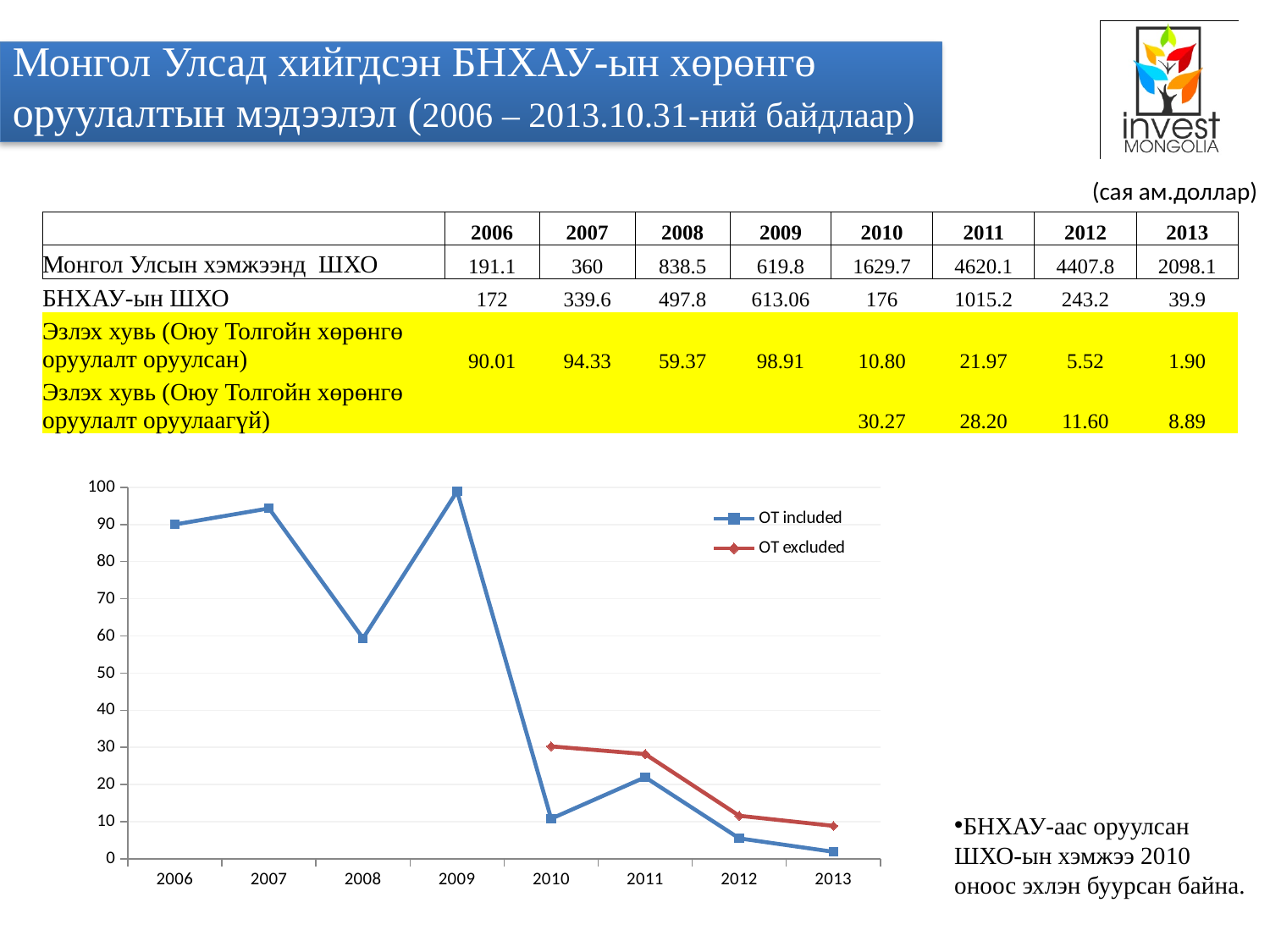
How many series does the chart legend list? 2 What are the two series named in the chart legend? OT included, OT excluded In which year does the OT included series reach its lowest value? 2013 In which year does the OT excluded series first appear on the chart? 2010 Does the OT excluded series rise or fall from 2010 to 2013? fall Is the OT included value for 2010 greater or less than 20? less Is the OT included value for 2008 greater or less than 50? greater What kind of chart is shown on the slide? line chart In 2011, which series has the larger value, OT included or OT excluded? OT excluded How many years are shown on the x axis of the chart? 8 In which year does the OT included series reach its highest value? 2009